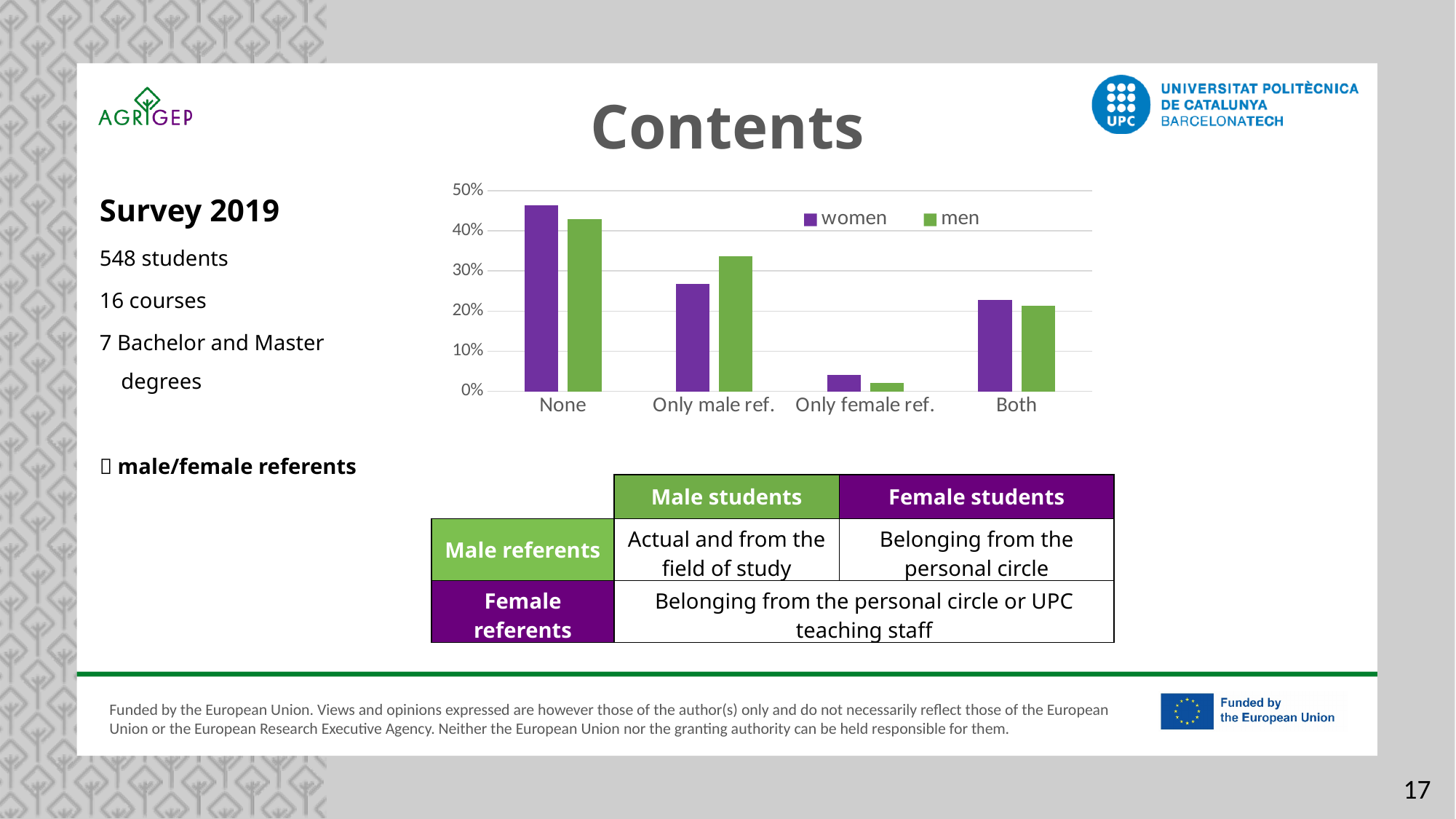
Is the value for women in the None category greater or less than 40%? greater How many series does the chart's legend list? 2 Which category has the highest value for women? None For the category Only male ref., which series has the larger value, women or men? men For the category Only female ref., which series has the larger value, women or men? women What kind of chart is shown on the slide? bar chart Is the value for men in the Only male ref. category greater or less than 30%? greater Which category has the lowest value for men? Only female ref. Which category has the lowest value for women? Only female ref. Which colour represents the women series in the chart? purple How many categories are shown on the x axis of the chart? 4 Which category has the highest value for men? None